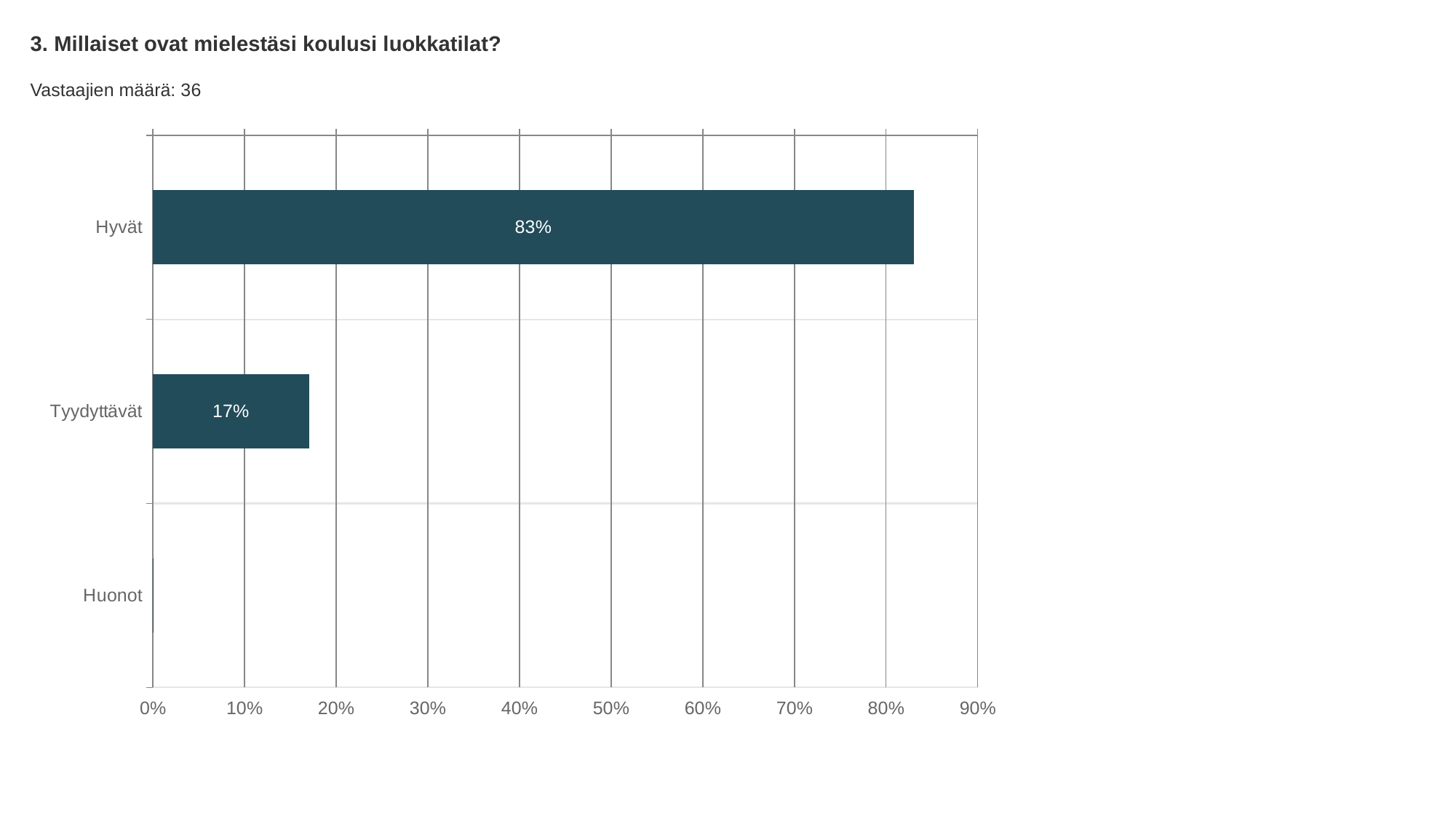
What is the difference between the values for Hyvät and Tyydyttävät? 66% Is the value for Tyydyttävät greater or less than 20%? less How many respondents (Vastaajien määrä) does the slide report? 36 Which category has the lowest value? Huonot Which is larger, the value for Hyvät or the value for Tyydyttävät? Hyvät How many categories are shown in the chart? 3 Which category has the highest value? Hyvät What is the value for Tyydyttävät? 17% What is the value for Hyvät? 83% Is the value for Hyvät greater or less than 80%? greater What kind of chart is shown on the slide? bar chart What is the title of the chart? 3. Millaiset ovat mielestäsi koulusi luokkatilat?